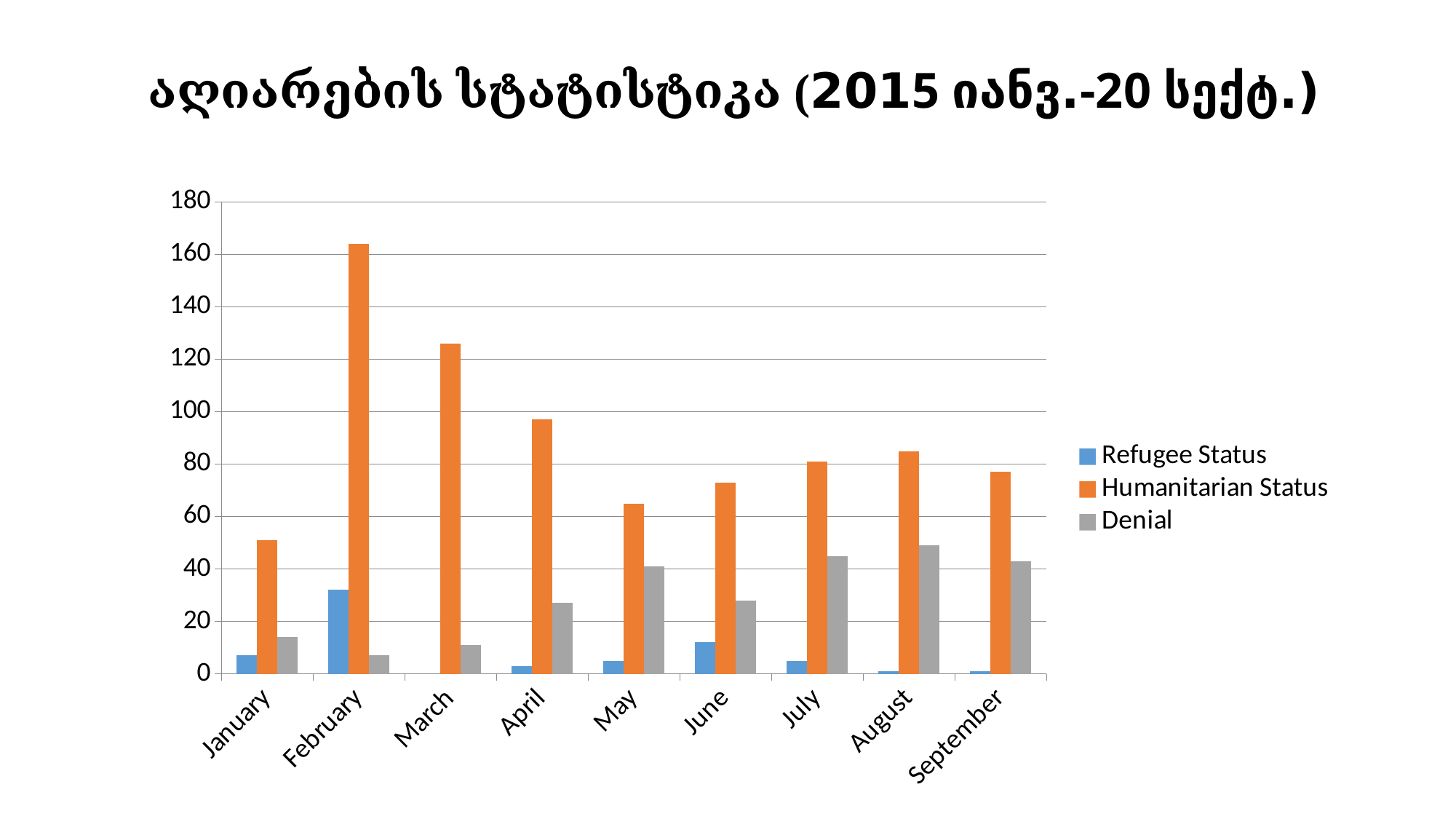
Does the Humanitarian Status value rise or fall from February to May? fall Is the Humanitarian Status value for March greater or less than 140? less In which month is the Humanitarian Status value highest? February How many series does the legend list? 3 In which month is the Denial value lowest? February Which is larger, the Humanitarian Status value for March or for April? March How many months are shown on the x axis? 9 What kind of chart is shown on the slide? bar chart Is the Humanitarian Status value for January greater or less than 60? less Which is larger, the Denial value for May or for June? May Is the Humanitarian Status value for February greater or less than 140? greater In which month is the Refugee Status value highest? February